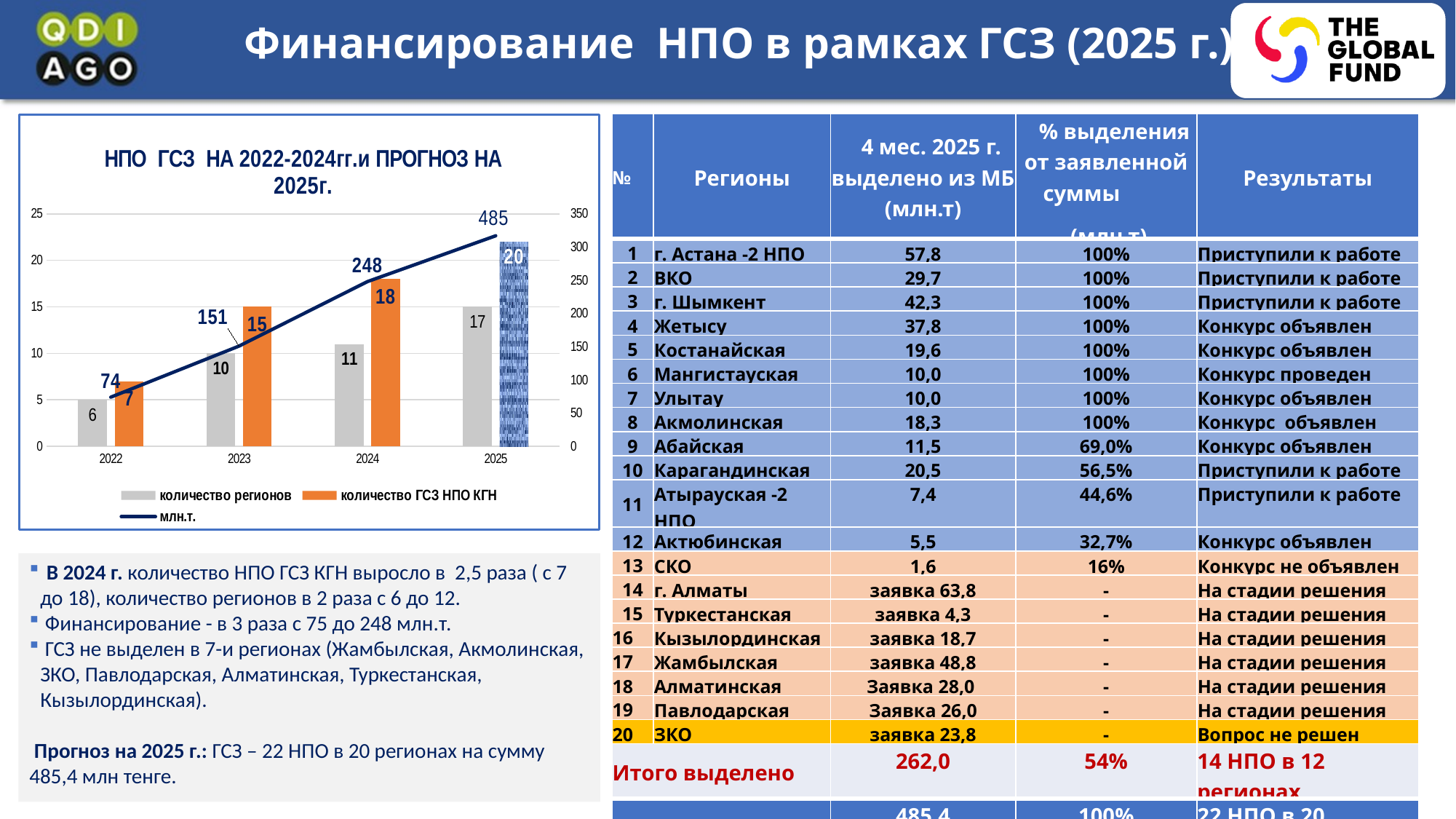
In the chart, what is the value of количество регионов for 2023? 10 In the chart, what is the value of количество ГСЗ НПО КГН for 2024? 18 In the chart, which year has the highest value on the млн.т. line? 2025 In the chart, what is the difference between the млн.т. values for 2024 and 2023? 97 What is the title of the chart on the left of the slide? НПО ГСЗ НА 2022-2024гг.и ПРОГНОЗ НА 2025г. In the chart, what is the value of the млн.т. line for 2024? 248 In the chart, which is larger for 2023: количество регионов or количество ГСЗ НПО КГН? количество ГСЗ НПО КГН In the chart, what is the value of the млн.т. line for 2025? 485 In the chart, what is the value of the млн.т. line for 2022? 74 Does the млн.т. line in the chart rise or fall from 2022 to 2025? rise In the chart, which year has the lowest value for количество регионов? 2022 How many series does the chart's legend list? 3